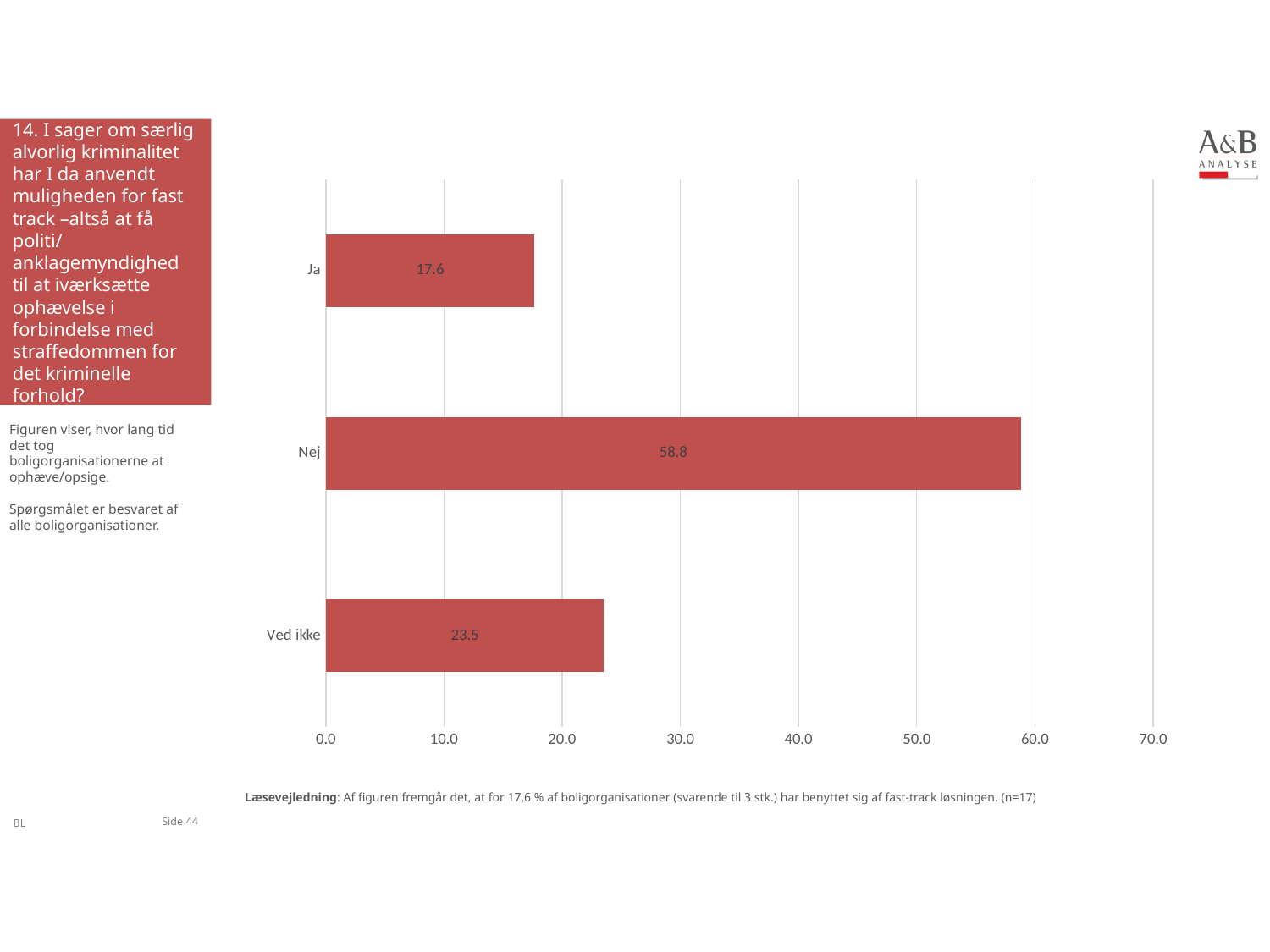
How many categories are shown in the chart? 3 What is the value for "Nej"? 58.8 What is the difference between the values for "Ved ikke" and "Ja"? 5.9 What is the value for "Ja"? 17.6 What is the value for "Ved ikke"? 23.5 What is the highest value shown on the x axis? 70.0 What kind of chart is shown on the slide? Bar chart Which category has the highest value? Nej Which category has the lowest value? Ja Which is larger, the value for "Ved ikke" or the value for "Ja"? Ved ikke Is the value for "Nej" greater or less than 50.0? greater What is the difference between the values for "Nej" and "Ja"? 41.2